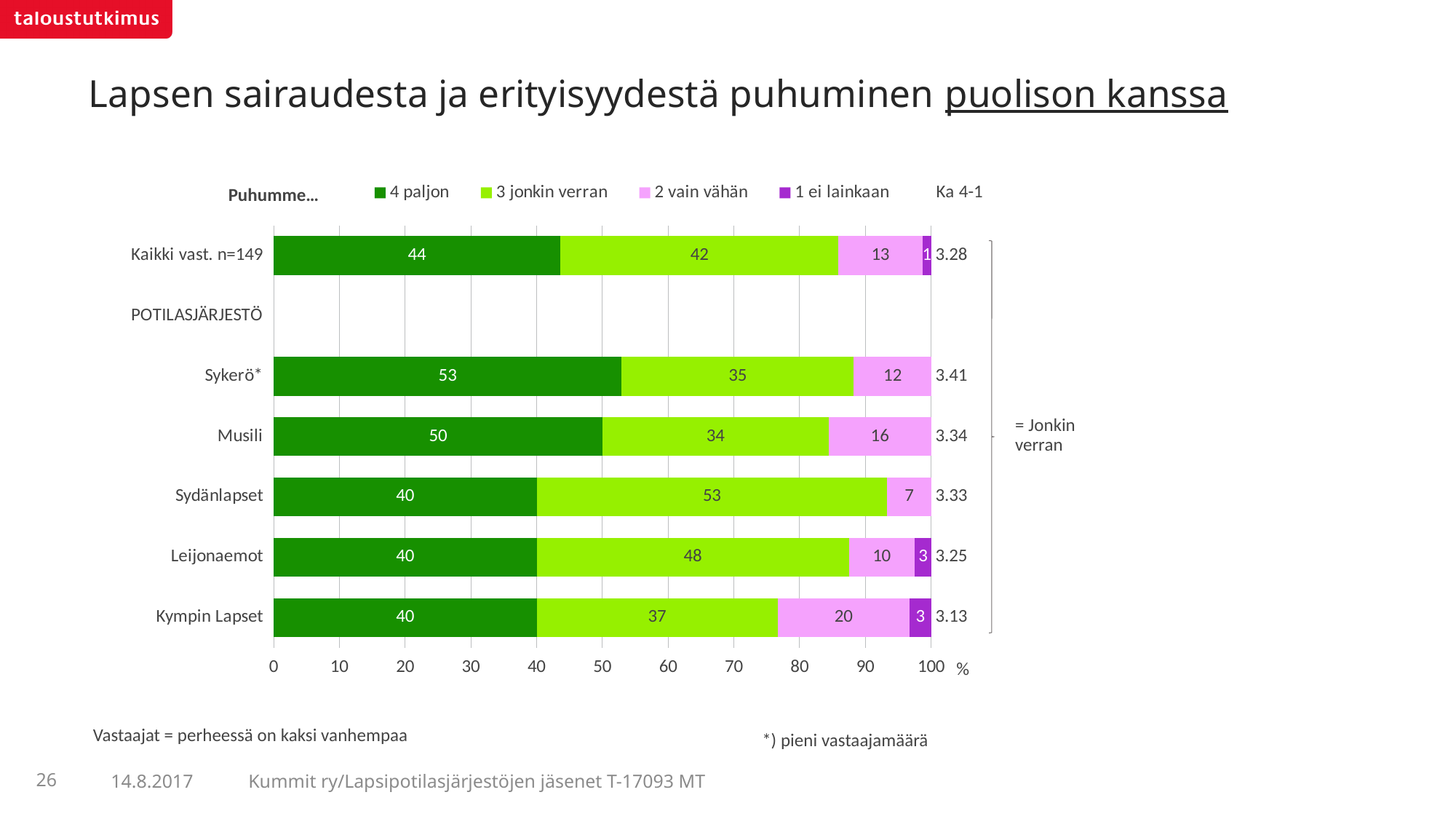
What is the difference between the "4 paljon" values for Musili and Sydänlapset? 10 Which category has the lowest value for "2 vain vähän"? Sydänlapset How many series does the legend list (excluding the Ka 4-1 label)? 4 What is the Ka 4-1 value for Kaikki vast. n=149? 3.28 What is the total of the stacked bar for Kaikki vast. n=149? 100 What kind of chart is shown on the slide? Stacked bar chart Which has a larger "3 jonkin verran" value, Sydänlapset or Leijonaemot? Sydänlapset Which category has the highest value for "4 paljon"? Sykerö* How many categories have bars plotted in the chart? 6 What is the value of "2 vain vähän" for Kympin Lapset? 20 Which category has the highest Ka 4-1 value? Sykerö* What is the value of "4 paljon" for Sykerö*? 53